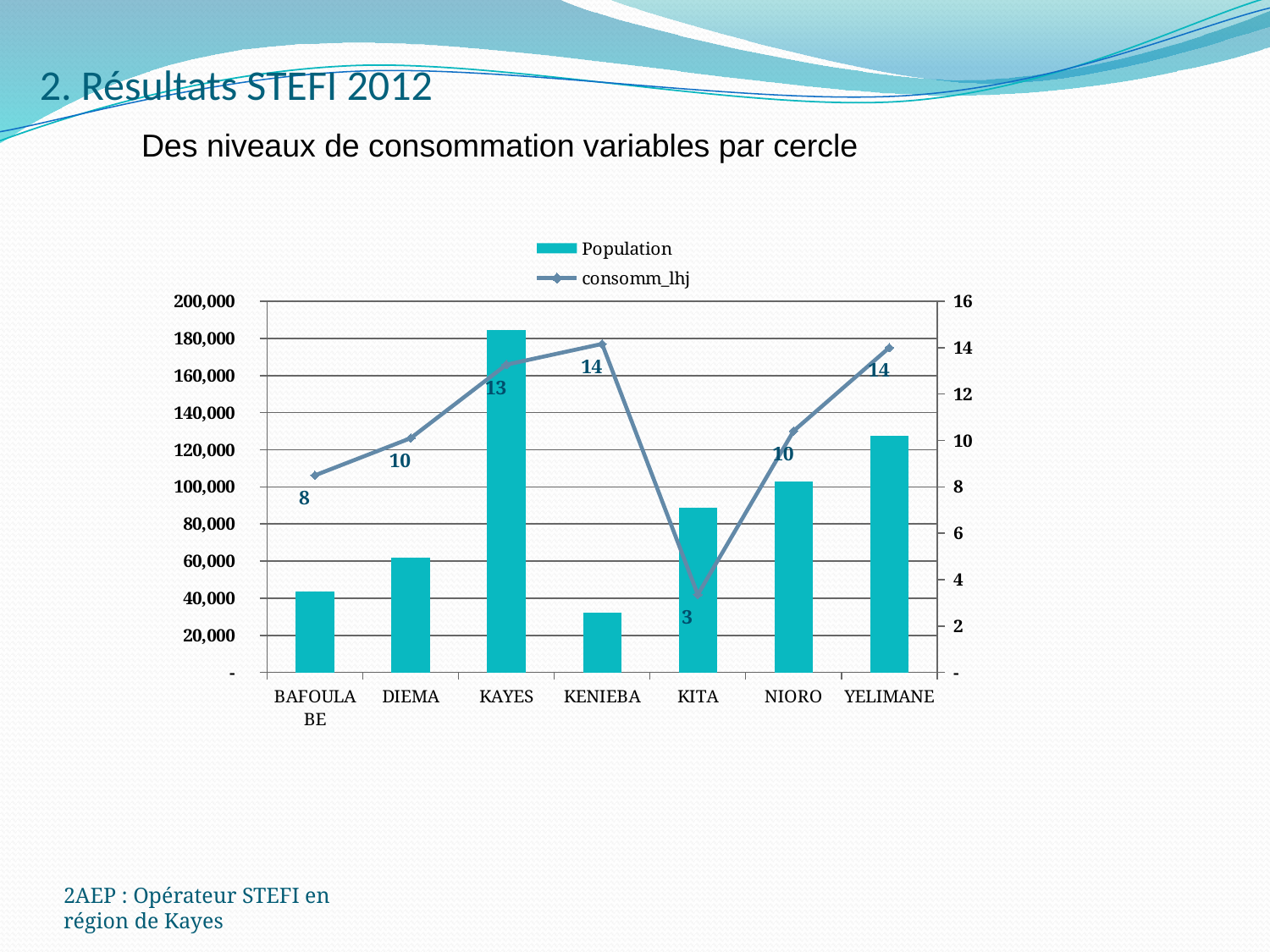
Which cercle has the lowest consomm_lhj value? KITA What is the consomm_lhj value for KITA? 3 Which has the larger Population bar, KAYES or NIORO? KAYES How many series does the chart legend list? 2 What is the consomm_lhj value for KAYES? 13 How many cercles are shown on the x axis of the chart? 7 Is the Population value for KENIEBA greater or less than 40,000? less Is the Population value for KAYES greater or less than 160,000? greater Which cercle has the highest Population bar? KAYES What is the consomm_lhj value for BAFOULABE? 8 What is the difference between the consomm_lhj values for KENIEBA and KITA? 11 Which cercle has the lowest Population bar? KENIEBA